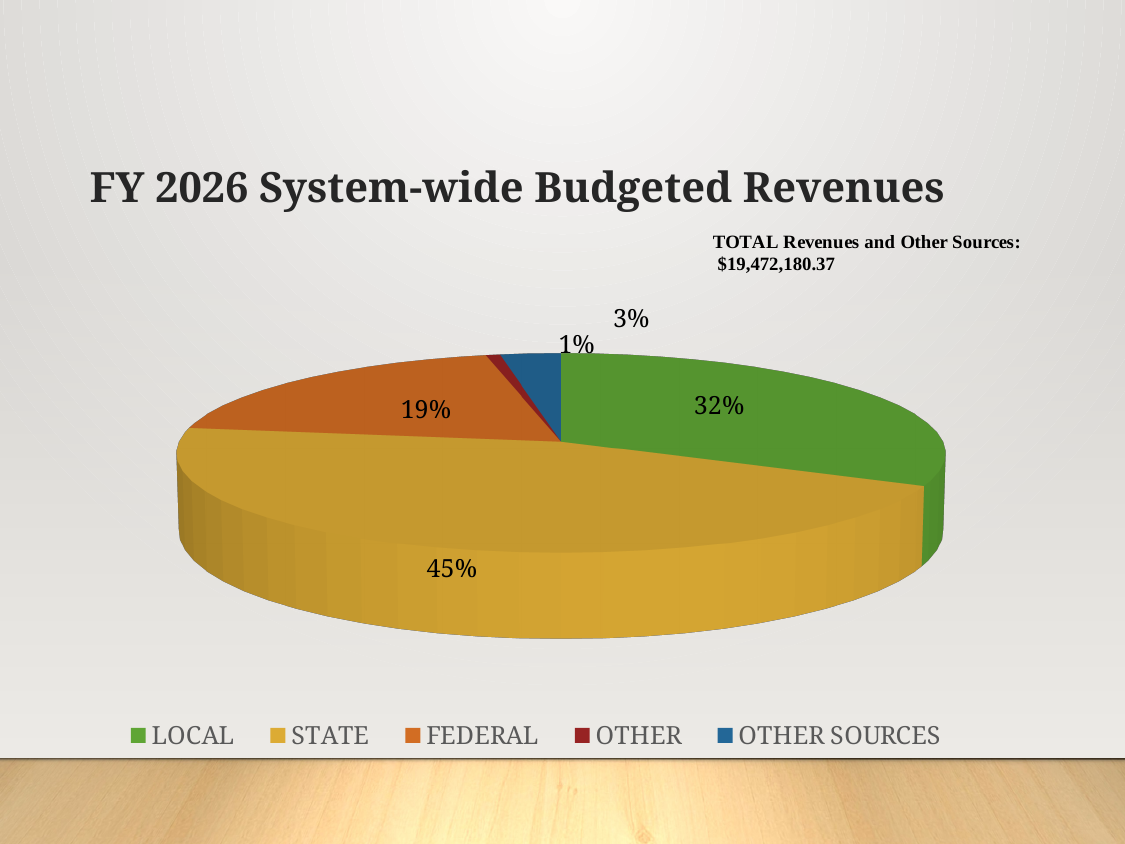
What share of the pie does OTHER represent? 1% How many categories does the legend list? 5 What share of the pie does STATE represent? 45% What is the title of the chart? FY 2026 System-wide Budgeted Revenues What kind of chart is shown on the slide? Pie chart Which is larger, the LOCAL share or the FEDERAL share? LOCAL What share of the pie does FEDERAL represent? 19% Which category has the largest share of the pie? STATE Which category has the smallest share of the pie? OTHER What share of the pie does LOCAL represent? 32% What share of the pie does OTHER SOURCES represent? 3% What is the difference in percentage points between the STATE and LOCAL shares? 13